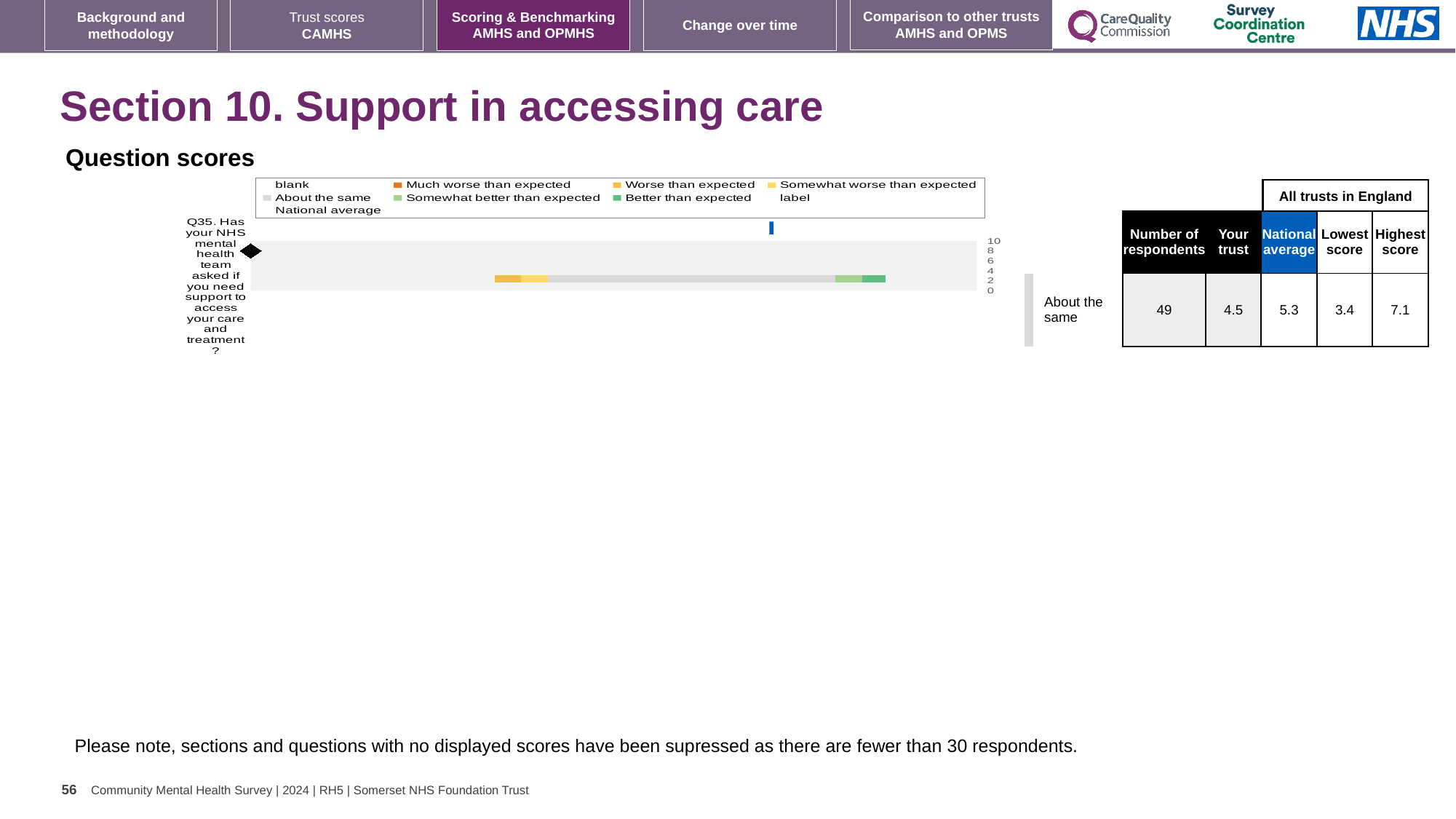
For Q35, what is the difference between the national average and the 'Your trust' score? 0.8 According to the table beside the chart, what is the national average score for Q35? 5.3 According to the table beside the chart, what is the highest score among all trusts in England for Q35? 7.1 According to the table beside the chart, how many respondents answered Q35? 49 According to the table beside the chart, what is the lowest score among all trusts in England for Q35? 3.4 How many questions are plotted in the Question scores chart? 1 What benchmark category is shown for Q35 next to the chart? About the same Which question is plotted in the Question scores chart? Q35. Has your NHS mental health team asked if you need support to access your care and treatment? According to the table beside the chart, what is the 'Your trust' score for Q35? 4.5 For Q35, what is the difference between the highest score and the lowest score among all trusts in England? 3.7 What kind of chart is shown under 'Question scores'? bar chart For Q35, which is larger: the 'Your trust' score or the national average? National average